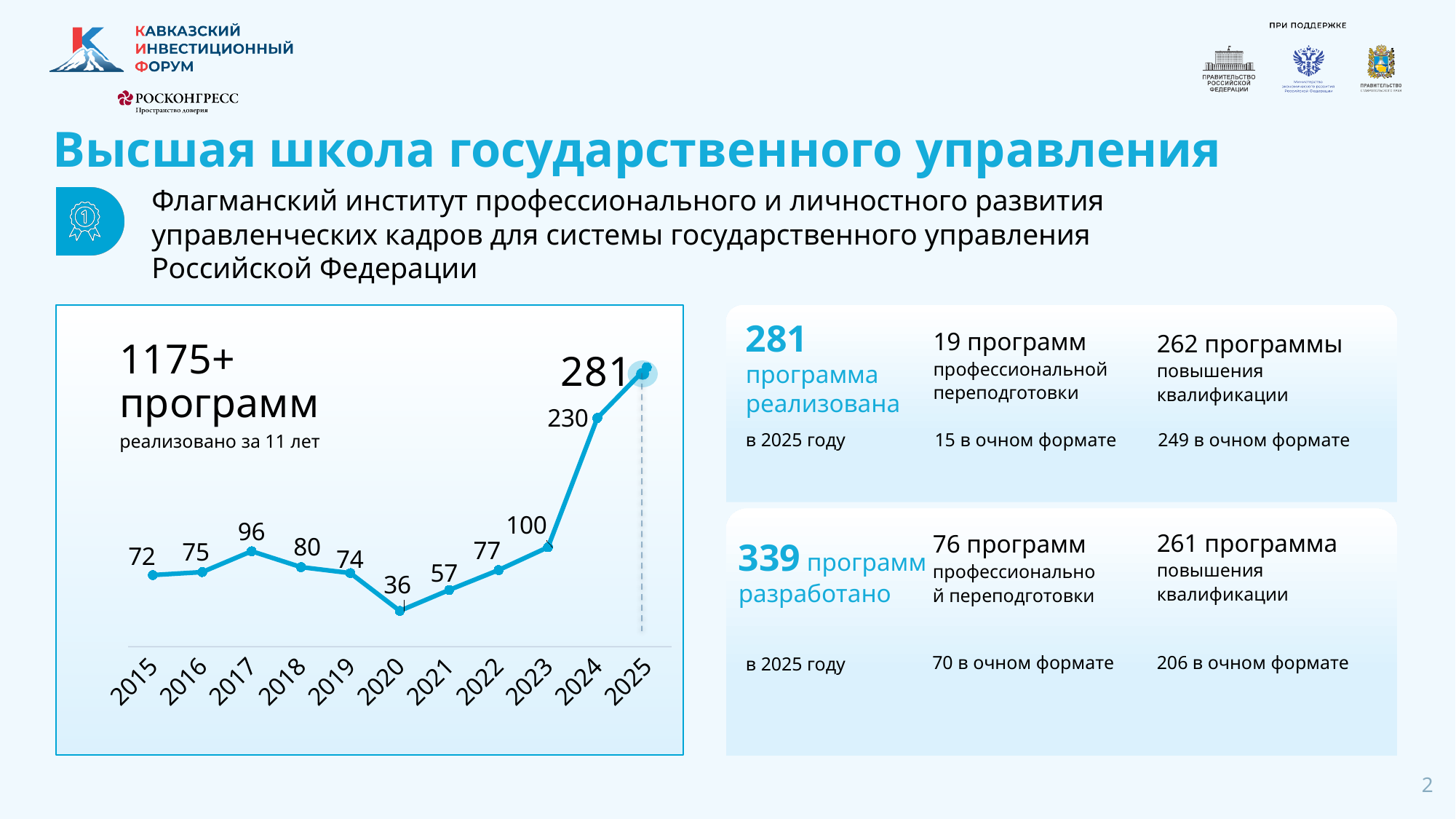
What is the difference between the values for 2025 and 2024? 51 How many years (data points) are plotted on the line chart? 11 Which year has the highest value on the line chart? 2025 What is the value for 2017 on the line chart? 96 What type of chart is shown on the slide? line chart What is the value for 2024 on the line chart? 230 Which year has the lowest value on the line chart? 2020 Do the values rise or fall from 2020 to 2025 on the line chart? rise What total number of programmes over 11 years is stated in the chart box? 1175+ Which is larger, the value for 2018 or the value for 2019? 2018 What is the difference between the values for 2023 and 2022? 23 What is the value for 2020 on the line chart? 36